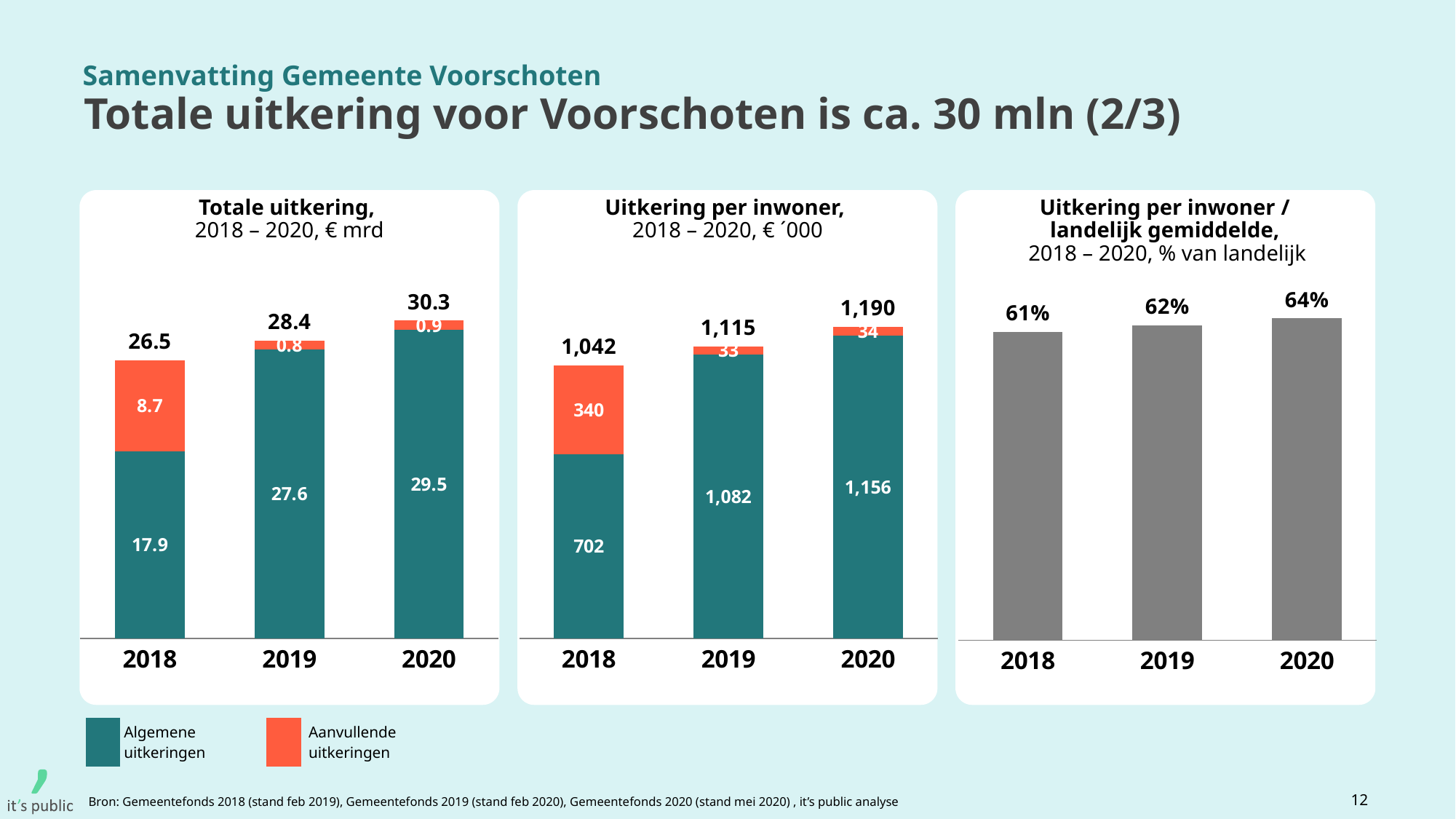
In the 'Totale uitkering' chart, what is the difference between the totals for 2020 and 2018? 3.8 In the 'Uitkering per inwoner' chart, what is the value of Algemene uitkeringen in 2019? 1,082 In the 'Uitkering per inwoner / landelijk gemiddelde' chart, what is the value for 2020? 64% In the 'Uitkering per inwoner' chart, is the Aanvullende uitkeringen value larger in 2018 or in 2020? 2018 In the 'Uitkering per inwoner' chart, what is the total for 2020? 1,190 What kind of chart is the 'Uitkering per inwoner / landelijk gemiddelde' chart? bar chart In the 'Totale uitkering' chart, what is the total for 2020? 30.3 How many series does the legend at the bottom of the slide list? 2 In the 'Uitkering per inwoner / landelijk gemiddelde' chart, do the values rise or fall from 2018 to 2020? rise In the 'Totale uitkering' chart, what is the value of Aanvullende uitkeringen in 2018? 8.7 In the 'Totale uitkering' chart, which year has the lowest total? 2018 In the 'Totale uitkering' chart, what is the value of Algemene uitkeringen in 2018? 17.9